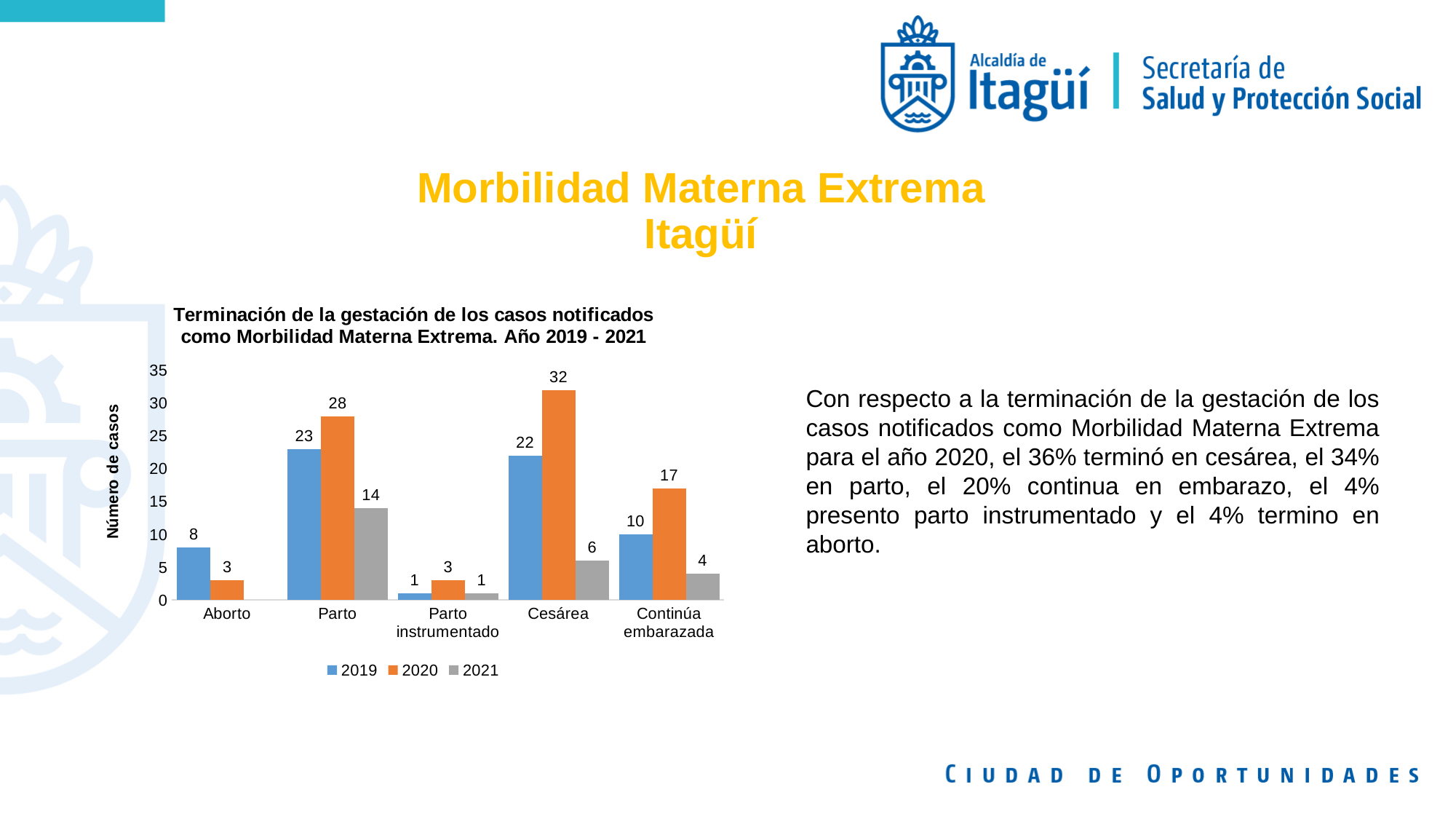
What is the value for Continúa embarazada in 2020? 17 What is the value for Aborto in 2019? 8 What kind of chart is shown on the slide? Bar chart What is the difference between the 2020 and 2019 values for Cesárea? 10 Which is larger, the 2019 value for Parto or the 2019 value for Cesárea? Parto What is the value for Parto in 2021? 14 How many categories are shown on the x axis? 5 Which category has the lowest value for 2019? Parto instrumentado How many series does the legend list? 3 What is the label of the vertical axis? Número de casos What is the value for Cesárea in 2020? 32 Which category has the highest value for 2020? Cesárea